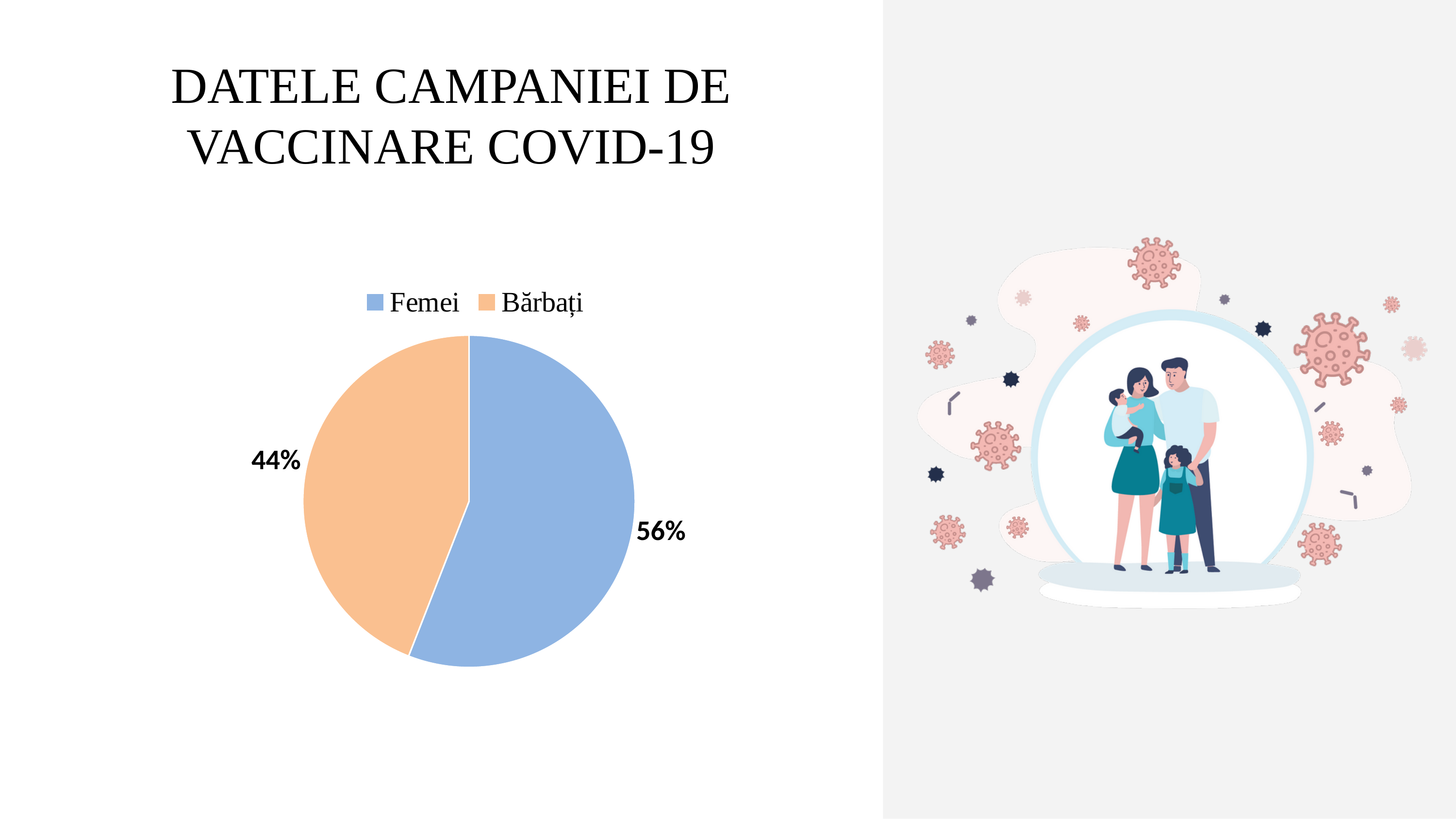
Which slice is the smallest in the pie chart? Bărbați Which is larger, the Femei slice or the Bărbați slice? Femei How many slices does the pie chart have? 2 What kind of chart is shown on the slide? pie chart What share of the pie does Bărbați represent? 44% What is the difference between the Femei and Bărbați shares? 12% What colour is the Femei slice? blue What colour is the Bărbați slice? orange How many entries does the legend list? 2 What share of the pie does Femei represent? 56% Which slice is the largest in the pie chart? Femei